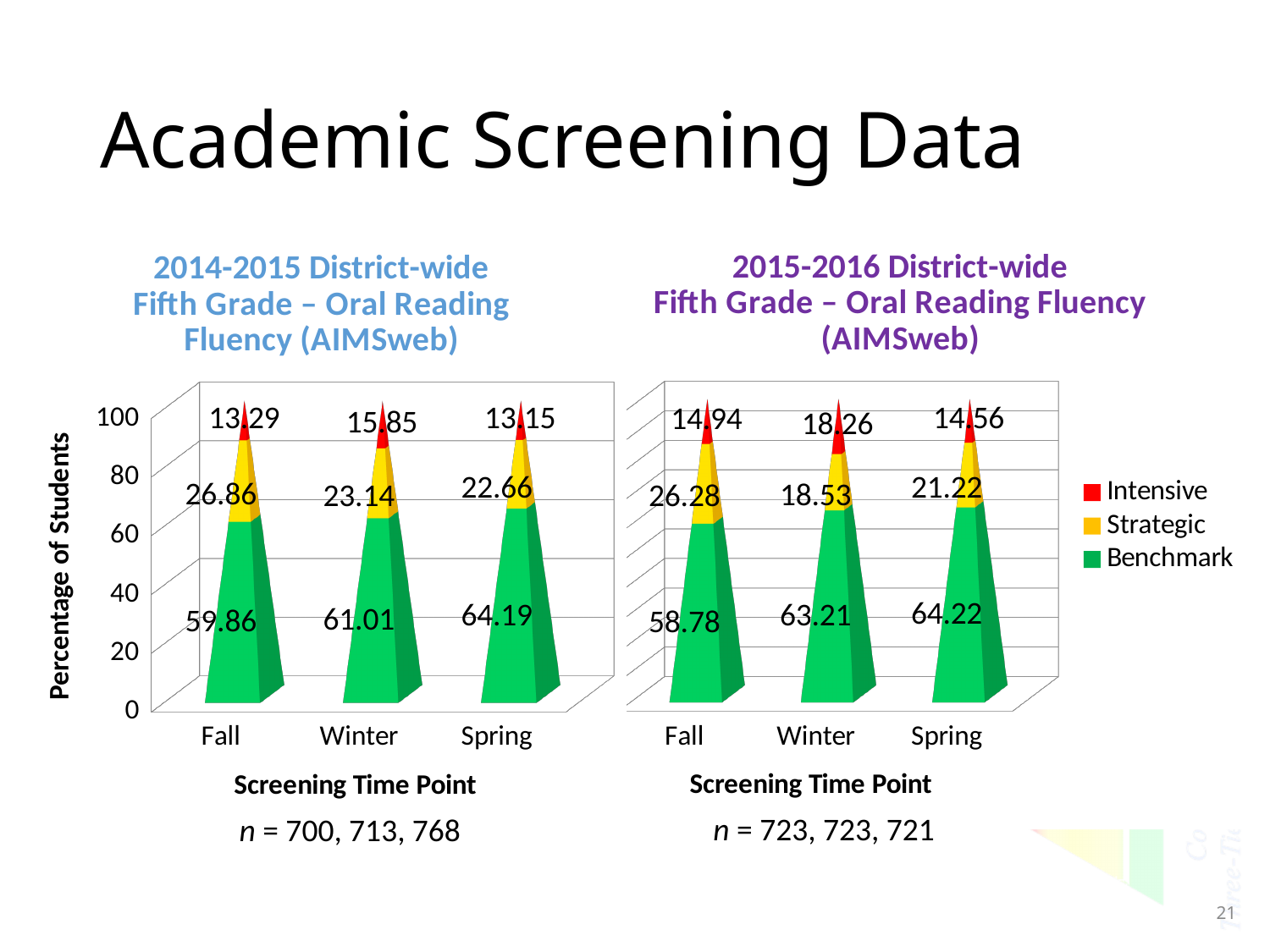
In the 2014-2015 chart, what is the difference between the Benchmark values for Spring and Fall? 4.33 In the 2015-2016 chart, what is the Strategic value for Fall? 26.28 In the 2015-2016 chart, do the Benchmark values rise or fall from Fall to Spring? Rise In the 2015-2016 chart, which screening time point has the lowest Strategic value? Winter How many screening time points are shown in the 2015-2016 chart? 3 In the 2014-2015 chart, what is the Strategic value for Spring? 22.66 What kind of chart is the 2014-2015 chart? Stacked bar chart In the 2014-2015 chart, what is the Benchmark value for Fall? 59.86 In the 2014-2015 chart, which screening time point has the highest Benchmark value? Spring In the 2015-2016 chart, which is larger, the Intensive value for Fall or for Spring? Fall How many series does the legend list? 3 In the 2015-2016 chart, what is the Intensive value for Winter? 18.26